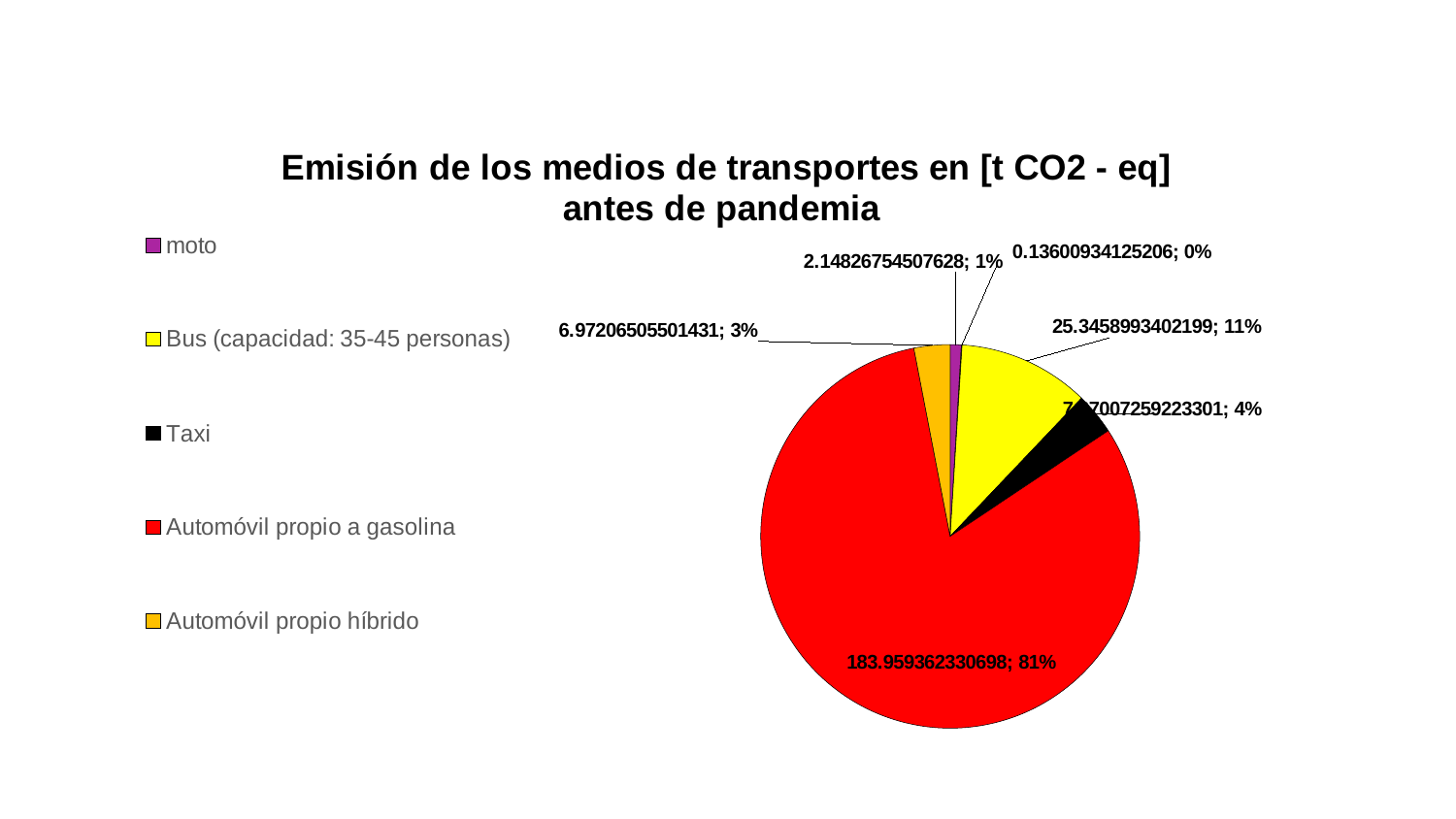
Which category has the largest slice of the pie? Automóvil propio a gasolina What share of the pie does Taxi represent? 4% What is the value for Bus (capacidad: 35-45 personas)? 25.3458993402199 What share of the pie does Automóvil propio híbrido represent? 3% What is the value for moto? 2.14826754507628 What share of the pie does Automóvil propio a gasolina represent? 81% What is the value for Automóvil propio híbrido? 6.97206505501431 Which is larger, the value for Bus (capacidad: 35-45 personas) or the value for Taxi? Bus (capacidad: 35-45 personas) What is the value for Automóvil propio a gasolina? 183.959362330698 What kind of chart is shown on the slide? pie chart How many entries does the legend list? 5